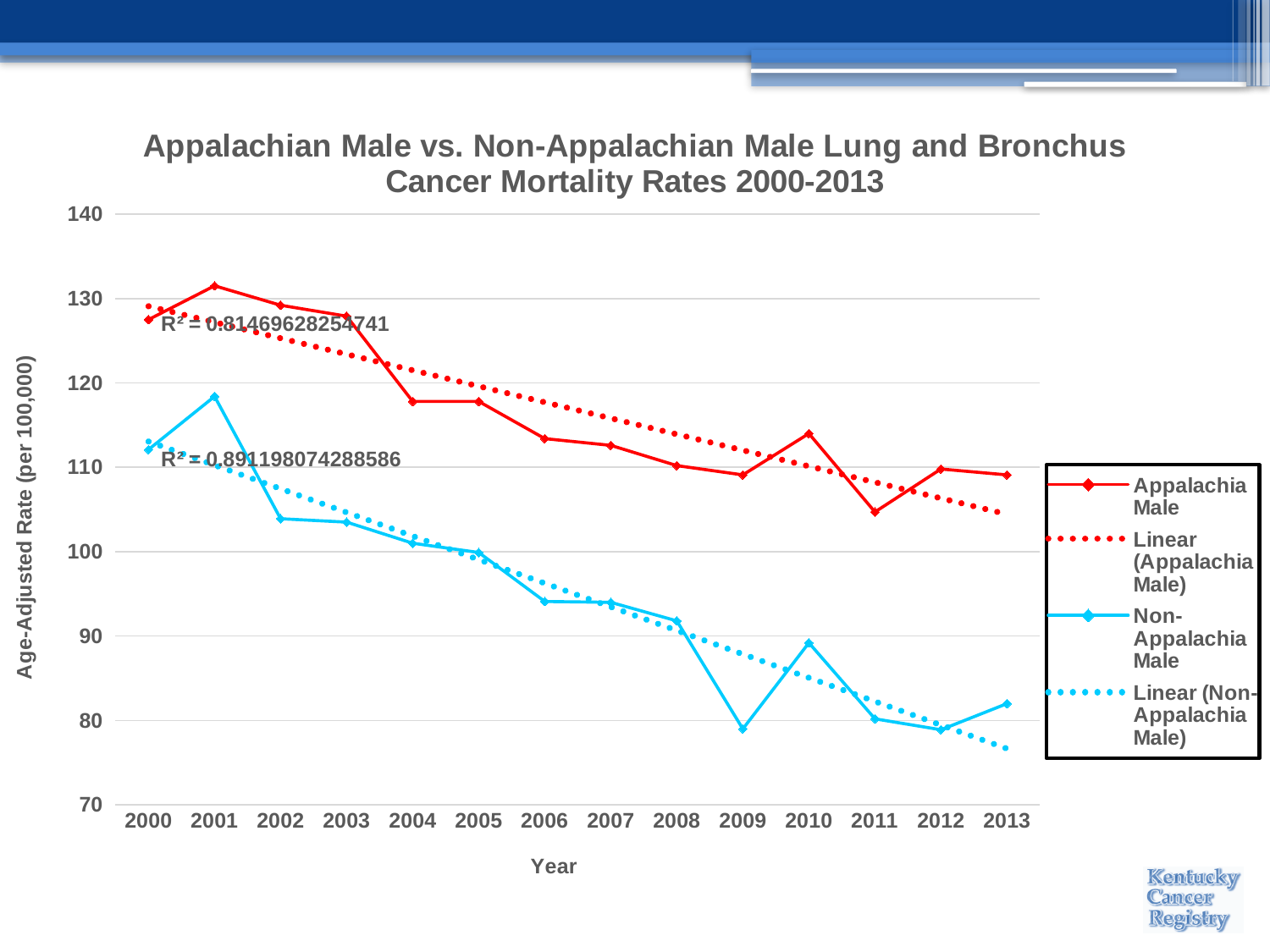
What kind of chart is shown on the slide? line chart What R² value is printed for the Non-Appalachia Male linear trendline? 0.891198074288586 In which year is the Appalachia Male mortality rate lowest? 2011 Is the Non-Appalachia Male value for 2002 greater or less than 100? greater Is the Appalachia Male value for 2001 greater or less than 130? greater How many entries does the legend list? 4 Is the Non-Appalachia Male value for 2009 greater or less than 80? less In which year is the Appalachia Male mortality rate highest? 2001 Which series has the higher value in 2010, Appalachia Male or Non-Appalachia Male? Appalachia Male How many years are shown on the x axis? 14 Do the Non-Appalachia Male mortality rates generally rise or fall from 2000 to 2013? fall In which year is the Non-Appalachia Male mortality rate highest? 2001